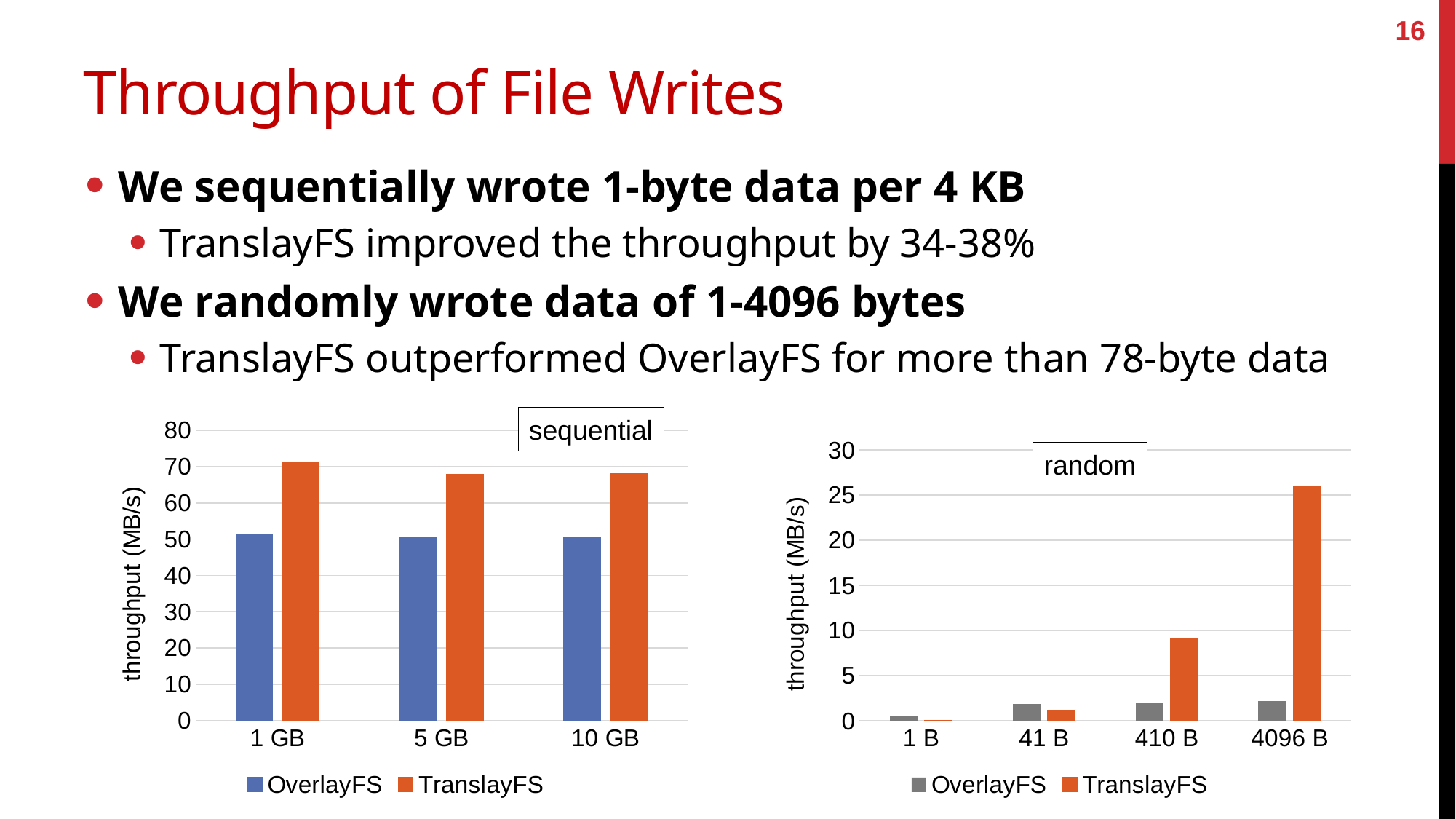
On the random chart, is the TranslayFS throughput at 4096 B greater or less than 20? greater On the random chart, which series has the higher throughput at 41 B, OverlayFS or TranslayFS? OverlayFS On the sequential chart, how many series does the legend list? 2 On the sequential chart, is the TranslayFS throughput at 1 GB greater or less than 60? greater On the sequential chart, which series has the higher throughput at 10 GB, OverlayFS or TranslayFS? TranslayFS On the random chart, how many write-size categories are shown on the x axis? 4 On the sequential chart, how many file-size categories are shown on the x axis? 3 On the random chart, does the TranslayFS throughput rise or fall as the write size increases along the x axis? rise On the sequential chart, at which file size is the TranslayFS bar highest? 1 GB On the sequential chart, is the OverlayFS throughput at 5 GB greater or less than 60? less On the sequential chart, what kind of chart is shown? bar chart On the random chart, at which write size is the TranslayFS bar highest? 4096 B